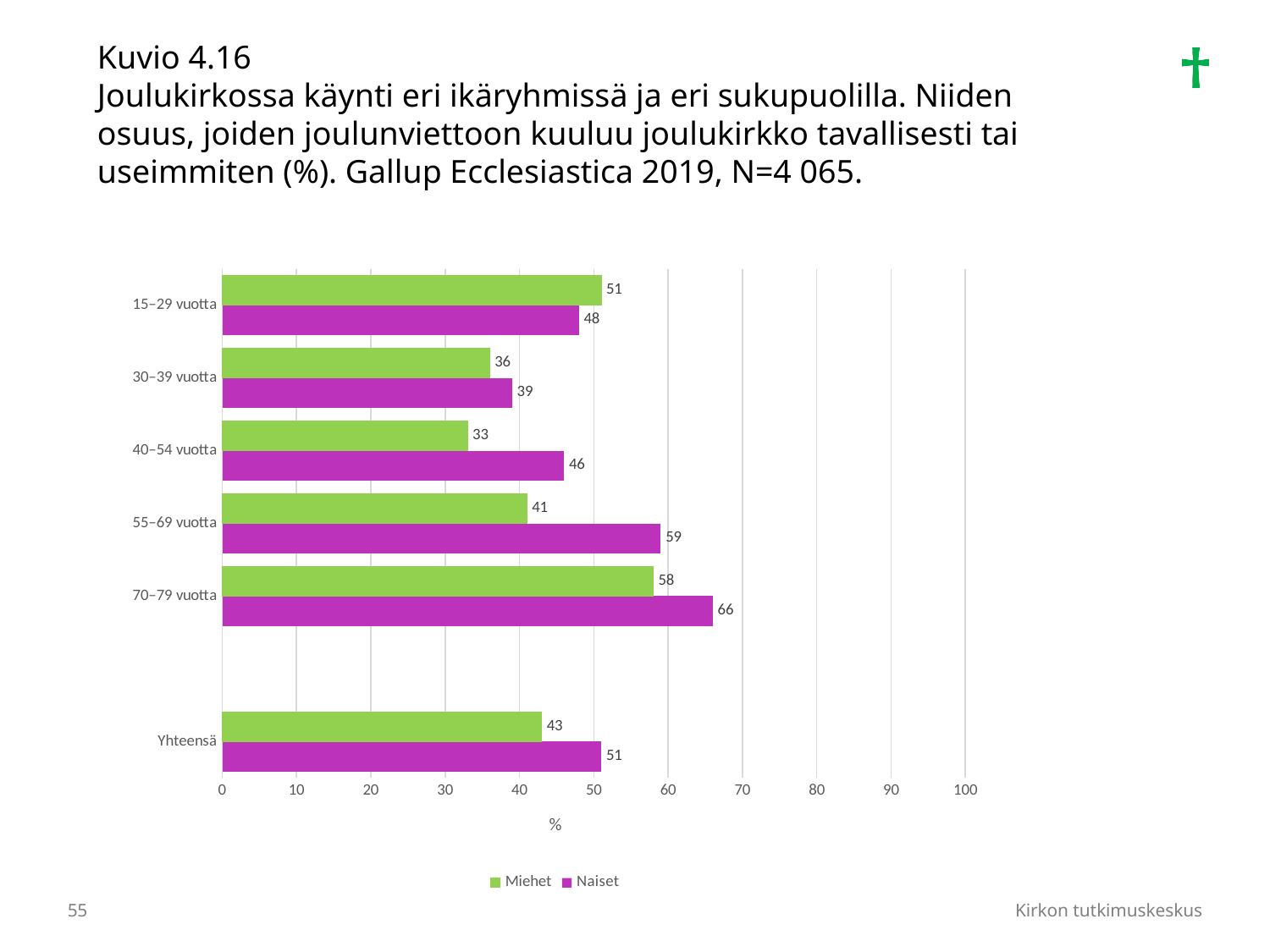
What is the value for Miehet in the 15–29 vuotta category? 51 What is the value for Naiset in the Yhteensä category? 51 Is the value for Naiset in the 70–79 vuotta category greater or less than 60? greater What is the value for Naiset in the 40–54 vuotta category? 46 How many series does the legend list? 2 What are the two series named in the legend? Miehet and Naiset What is the difference between the Naiset and Miehet values in the 55–69 vuotta category? 18 Which category has the lowest value for Miehet? 40–54 vuotta In the 30–39 vuotta category, which series has the larger value, Miehet or Naiset? Naiset How many categories are shown on the y axis of the chart? 6 What kind of chart is shown on the slide? bar chart Which category has the highest value for Naiset? 70–79 vuotta